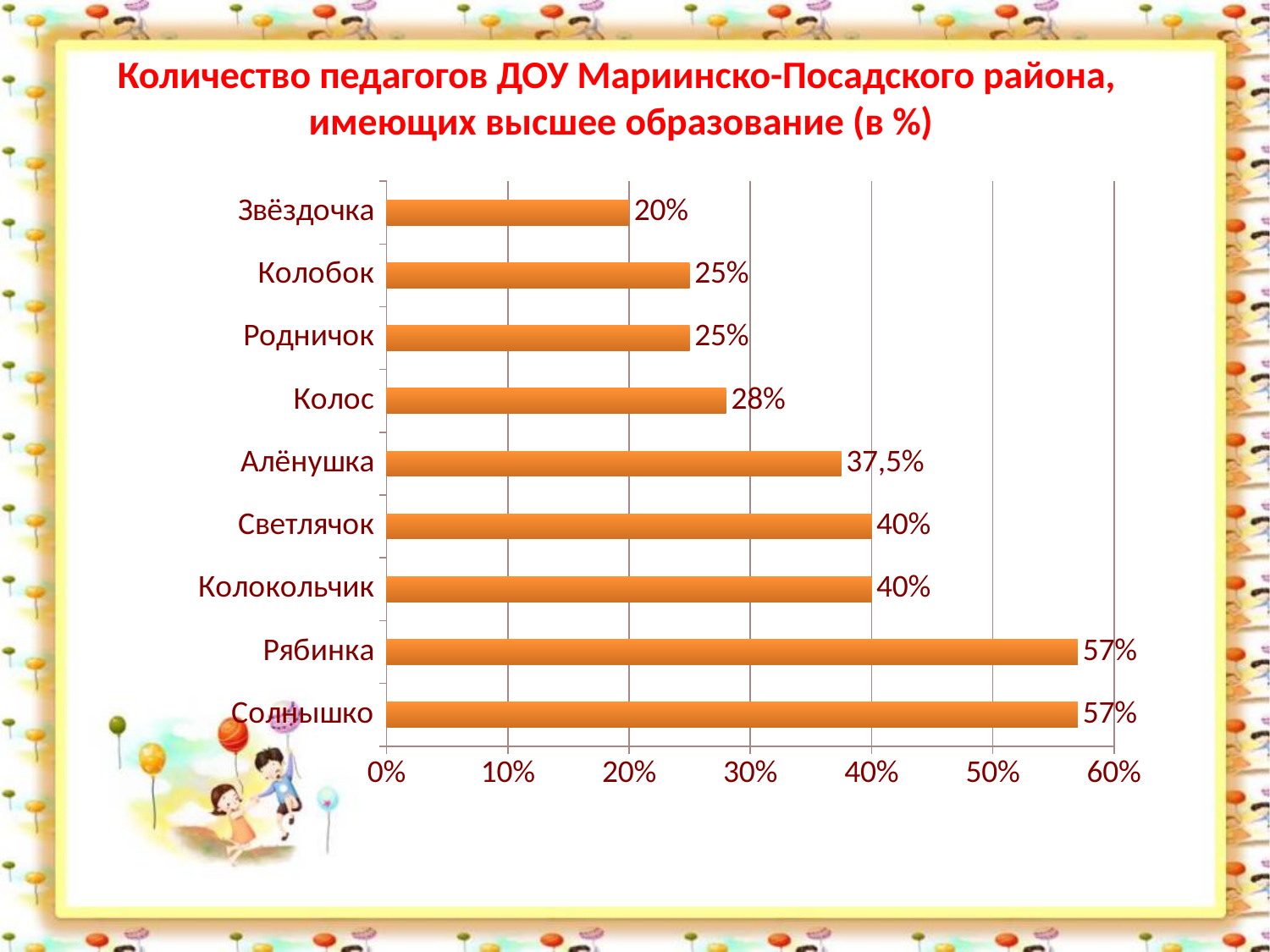
What is the value for Звёздочка? 20% Is the value for Солнышко greater or less than 50%? greater What kind of chart is shown on the slide? bar chart What is the difference between the values for Алёнушка and Колобок? 12,5% How many categories are shown in the chart? 9 What is the value for Колос? 28% What colour are the bars in the chart? orange Which is larger, the value for Колос or the value for Родничок? Колос What is the difference between the values for Рябинка and Светлячок? 17% Which category has the lowest value? Звёздочка What is the highest value shown on the x axis? 60% What is the value for Алёнушка? 37,5%